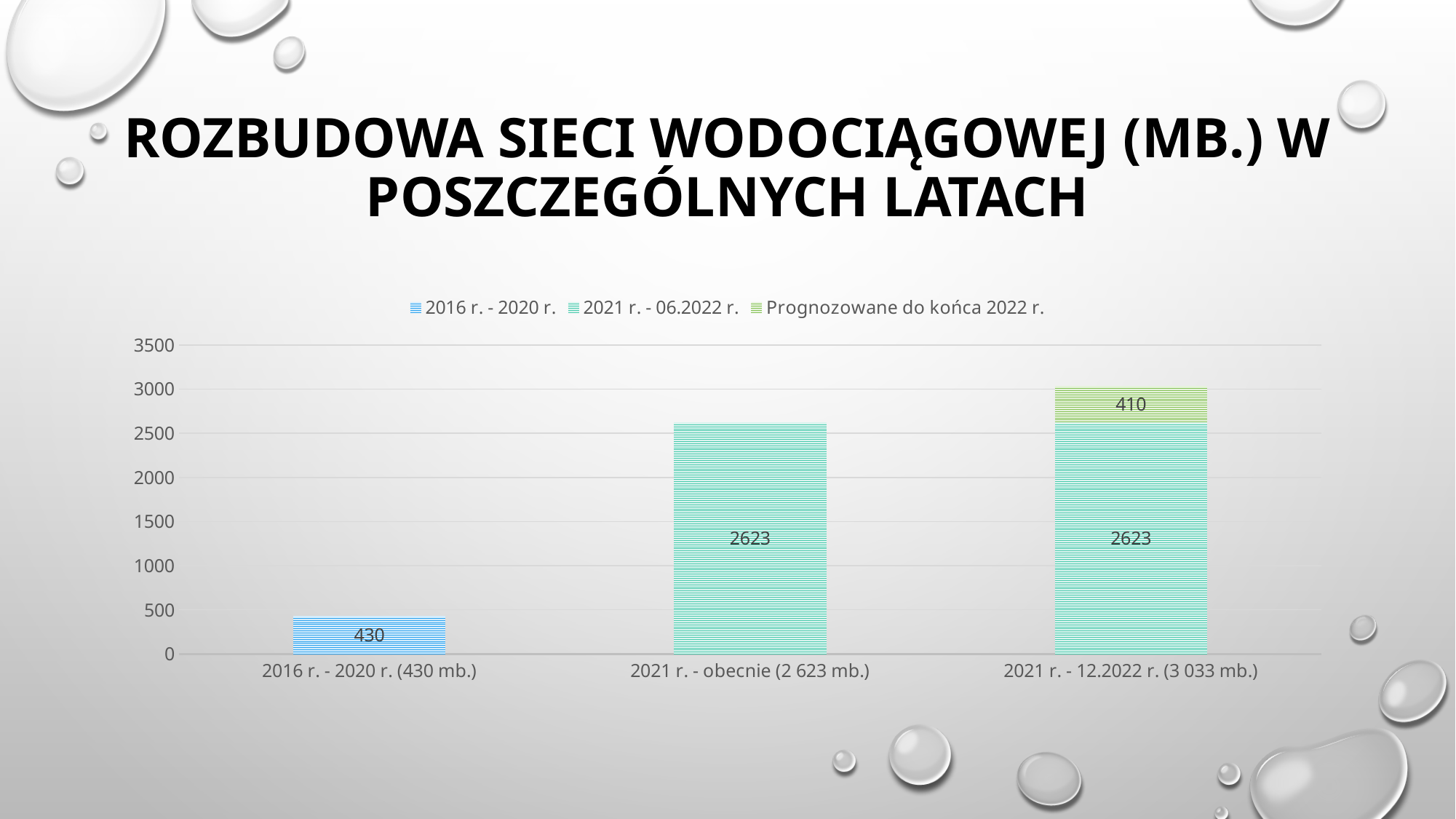
How many categories are shown on the x axis? 3 Which is larger: the '2016 r. - 2020 r.' value of 430 or the 'Prognozowane do końca 2022 r.' value of 410? 430 What is the value of the 'Prognozowane do końca 2022 r.' series for the category '2021 r. - 12.2022 r. (3 033 mb.)'? 410 What is the total of the stacked bar for the category '2021 r. - 12.2022 r. (3 033 mb.)'? 3033 Which category has the highest total bar height? 2021 r. - 12.2022 r. (3 033 mb.) Is the total bar for '2021 r. - 12.2022 r. (3 033 mb.)' greater or less than 3000? greater How many series does the legend list? 3 What is the difference between the '2021 r. - 06.2022 r.' value (2623) and the '2016 r. - 2020 r.' value (430)? 2193 Which category has the lowest total bar height? 2016 r. - 2020 r. (430 mb.) What is the value of the '2016 r. - 2020 r.' series for the category '2016 r. - 2020 r. (430 mb.)'? 430 What kind of chart is shown on the slide? Stacked bar chart What is the value of the '2021 r. - 06.2022 r.' series for the category '2021 r. - obecnie (2 623 mb.)'? 2623